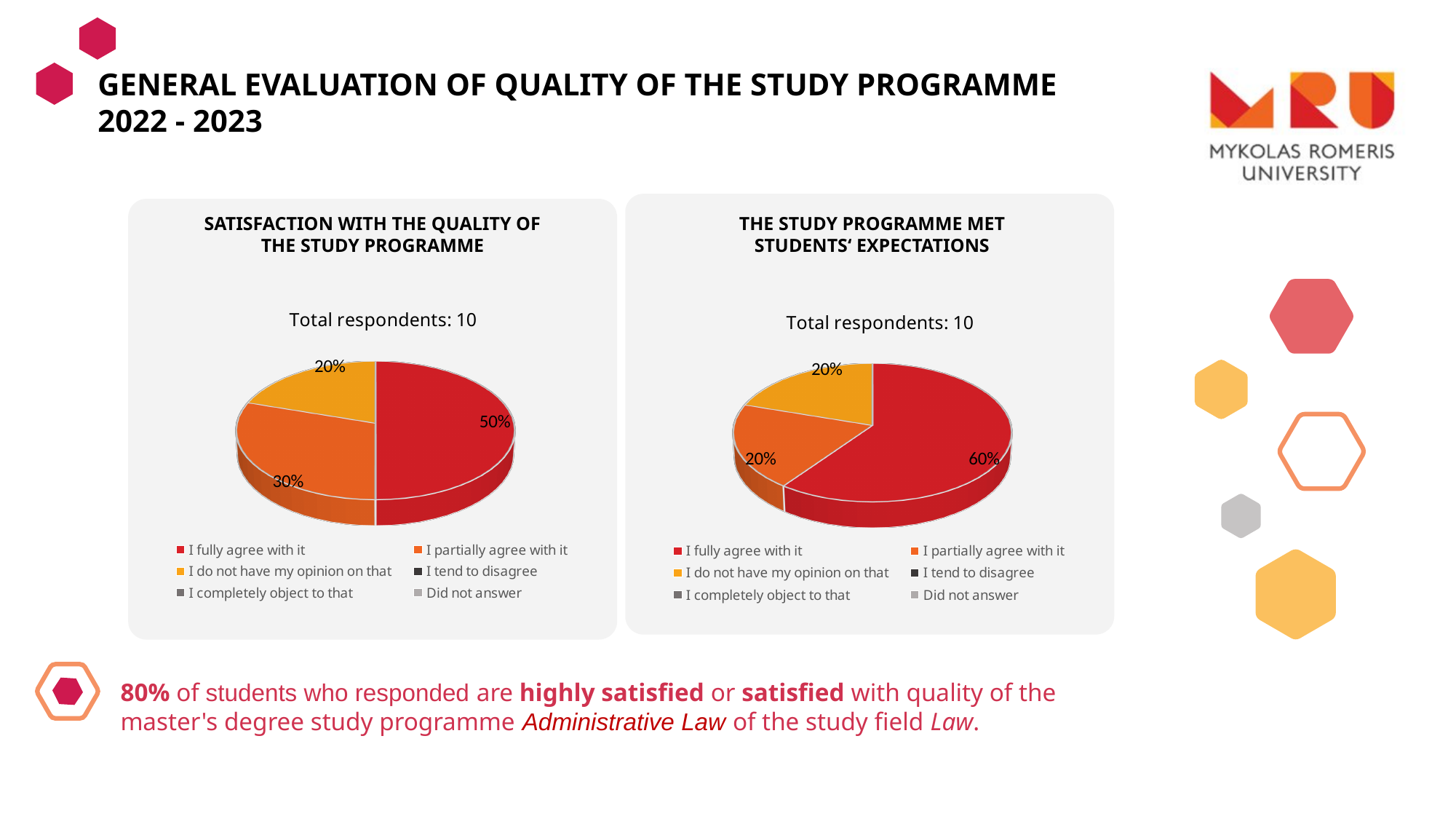
In 'The study programme met students' expectations' chart, which response has the largest slice? I fully agree with it Which chart has the larger share for 'I fully agree with it': 'Satisfaction with the quality of the study programme' or 'The study programme met students' expectations'? The study programme met students' expectations In the 'Satisfaction with the quality of the study programme' chart, what share of respondents chose 'I do not have my opinion on that'? 20% In the 'Satisfaction with the quality of the study programme' chart, what is the difference between the 'I fully agree with it' and 'I partially agree with it' shares? 20% In the 'Satisfaction with the quality of the study programme' chart, what share of respondents chose 'I partially agree with it'? 30% In the 'Satisfaction with the quality of the study programme' chart, what share of respondents chose 'I fully agree with it'? 50% How many entries does the legend of 'The study programme met students' expectations' chart list? 6 How many slices does the 'Satisfaction with the quality of the study programme' pie chart have? 3 In 'The study programme met students' expectations' chart, what share of respondents chose 'I partially agree with it'? 20% In the 'Satisfaction with the quality of the study programme' chart, which response has the largest slice? I fully agree with it What type of chart is used in 'The study programme met students' expectations'? Pie chart In 'The study programme met students' expectations' chart, what share of respondents chose 'I fully agree with it'? 60%